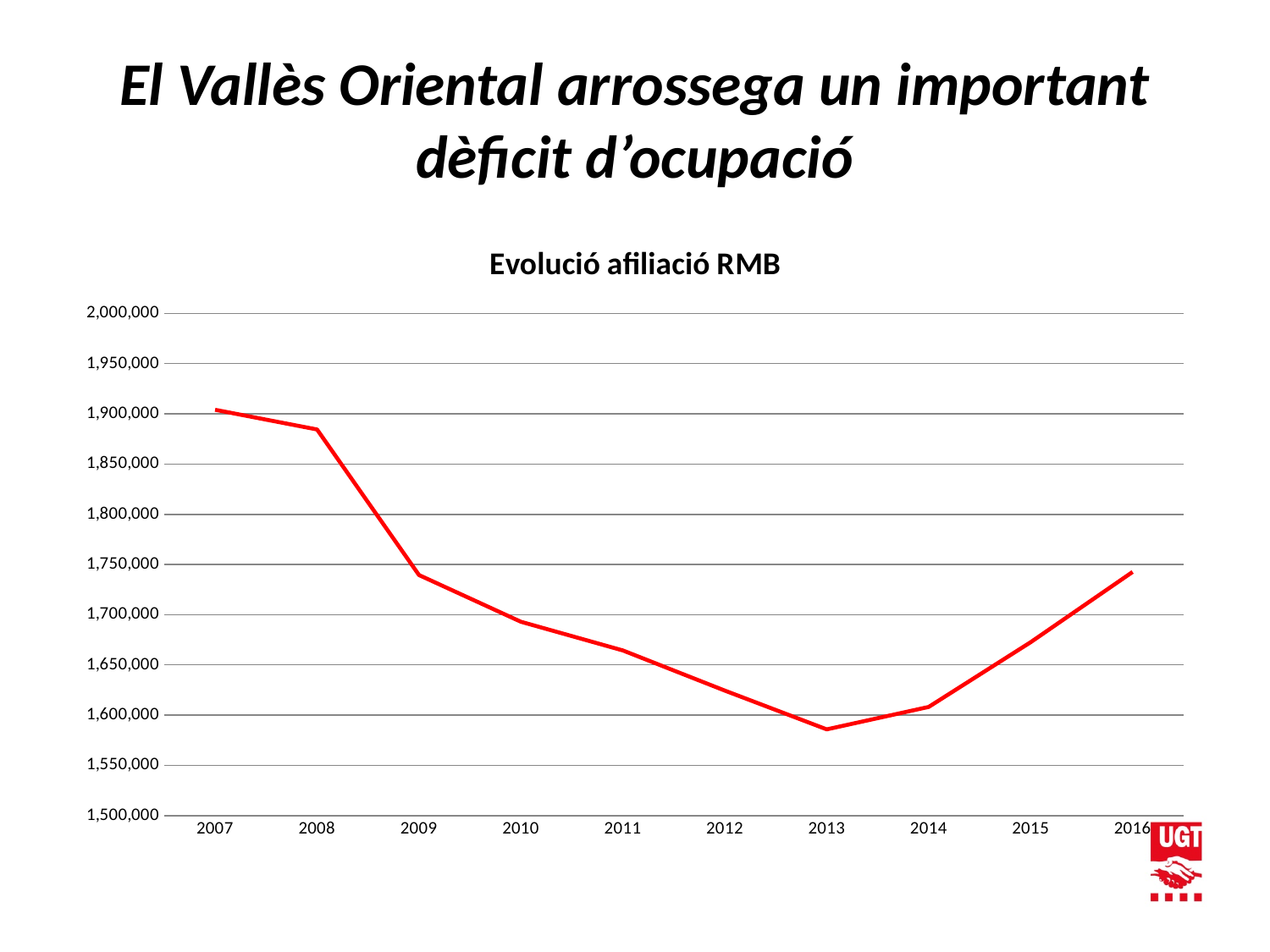
Is the value for 2007 greater or less than 1,850,000? greater Is the value for 2015 greater or less than 1,650,000? greater Is the value for 2012 greater or less than 1,600,000? greater Which year has the larger value, 2011 or 2014? 2011 Which year has the lowest value in the chart? 2013 What is the title of the chart? Evolució afiliació RMB Which year has the larger value, 2008 or 2015? 2008 How does the value change from 2007 to 2013? it falls Which year has the highest value in the chart? 2007 How many years are plotted on the x axis of the chart? 10 What kind of chart is shown on the slide? line chart